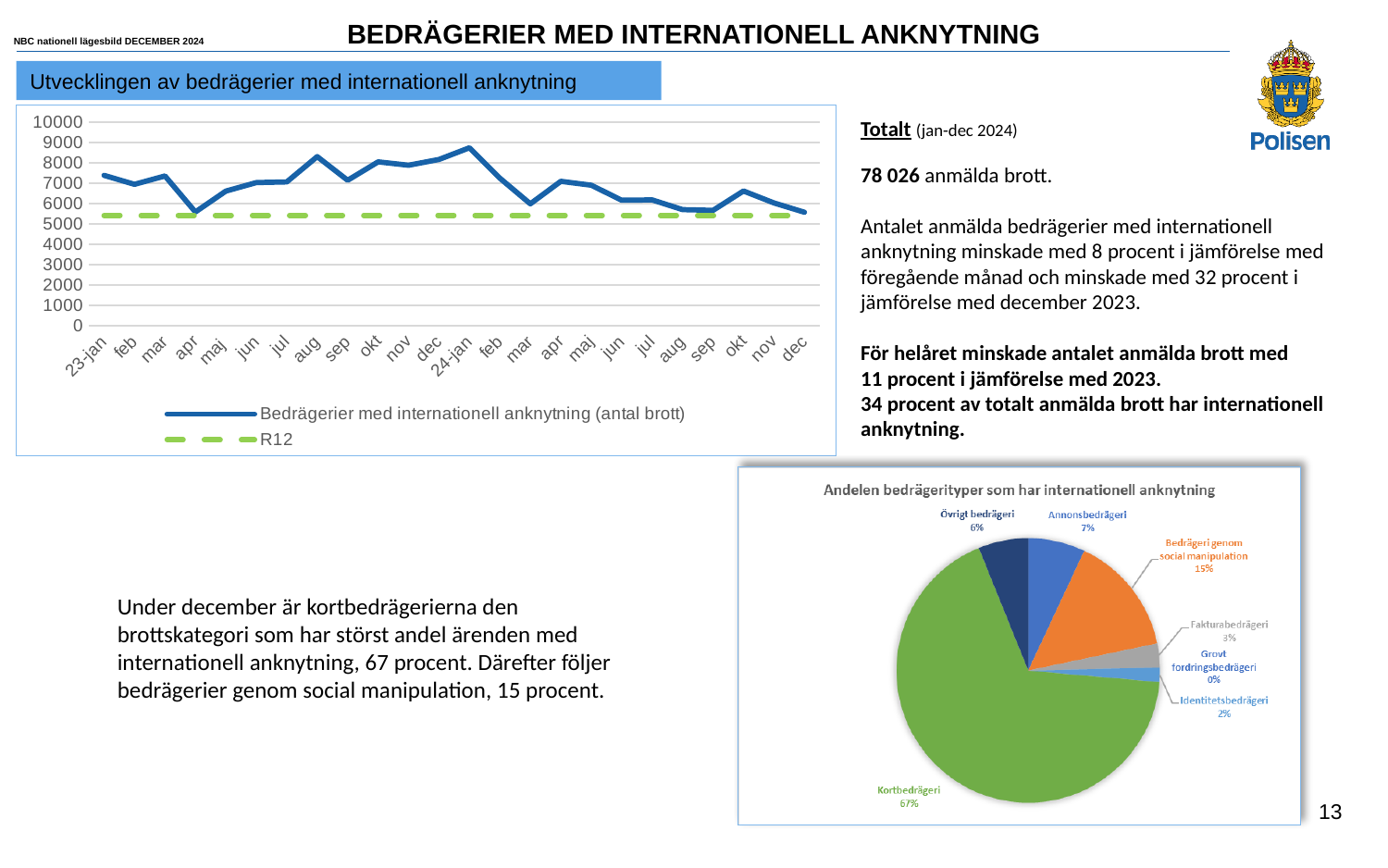
In the line chart "Utvecklingen av bedrägerier med internationell anknytning", is the value for Bedrägerier med internationell anknytning (antal brott) at dec 2024 greater or less than 6000? less What kind of chart is the chart titled "Andelen bedrägerityper som har internationell anknytning"? pie chart In the pie chart "Andelen bedrägerityper som har internationell anknytning", what share does Bedrägeri genom social manipulation have? 15% In the line chart "Utvecklingen av bedrägerier med internationell anknytning", does the Bedrägerier med internationell anknytning line rise or fall from 24-jan to dec? fall In the pie chart "Andelen bedrägerityper som har internationell anknytning", how many slices are there? 7 In the line chart "Utvecklingen av bedrägerier med internationell anknytning", is the R12 line above or below 6000? below In the pie chart "Andelen bedrägerityper som har internationell anknytning", what is the difference between the shares of Annonsbedrägeri and Fakturabedrägeri? 4% In the line chart "Utvecklingen av bedrägerier med internationell anknytning", is the value for Bedrägerier med internationell anknytning (antal brott) at 24-jan greater or less than 8000? greater In the line chart "Utvecklingen av bedrägerier med internationell anknytning", how many series does the legend list? 2 In the line chart "Utvecklingen av bedrägerier med internationell anknytning", which month has the highest value for Bedrägerier med internationell anknytning (antal brott)? 24-jan What kind of chart is the chart titled "Utvecklingen av bedrägerier med internationell anknytning"? line chart In the pie chart "Andelen bedrägerityper som har internationell anknytning", what share does Kortbedrägeri have? 67%